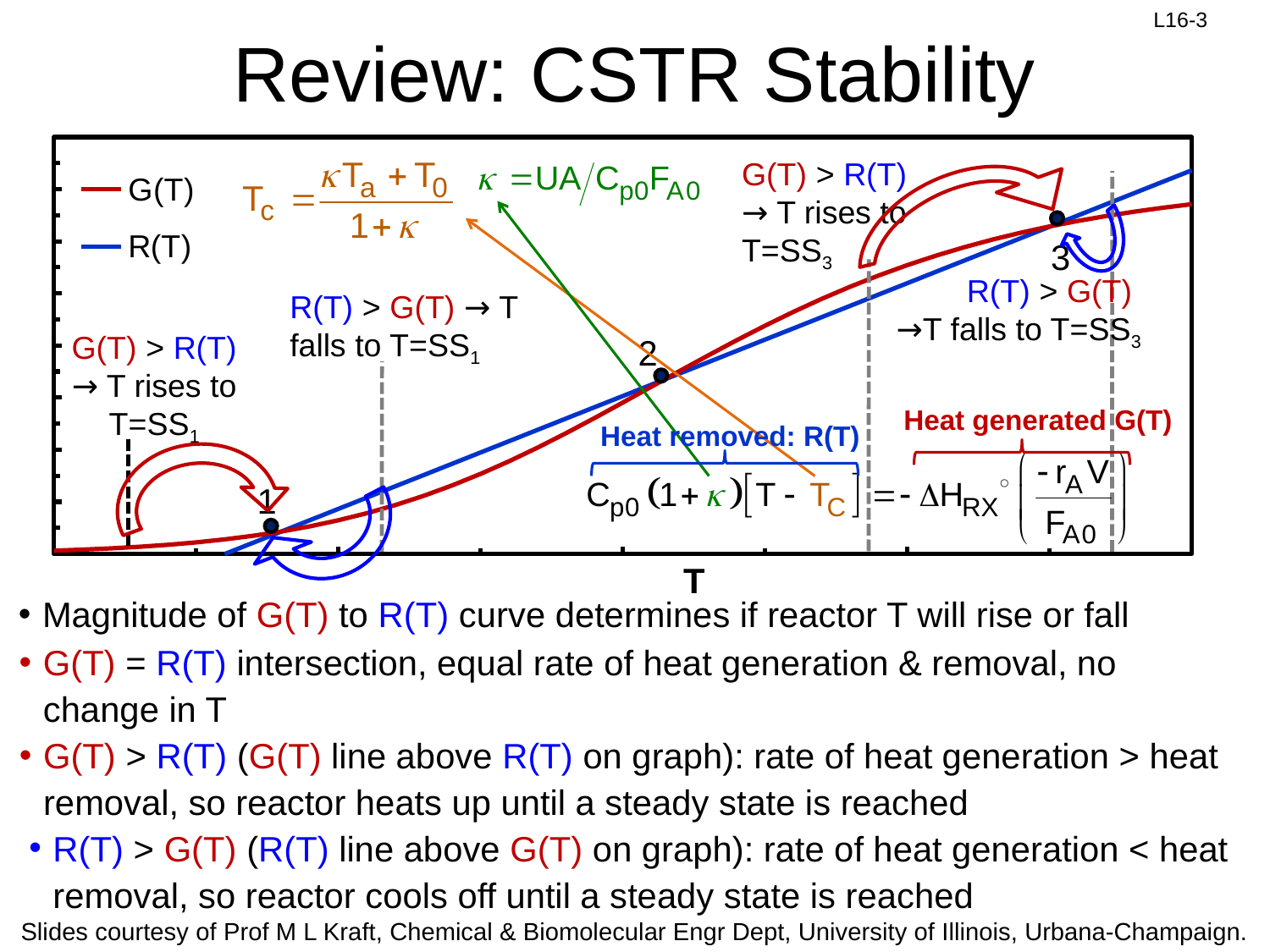
What are the two series named in the chart legend? G(T) and R(T) To the right of steady state 3, which curve is higher, G(T) or R(T)? R(T) How many series does the chart legend list? 2 Does the G(T) curve rise or fall as T increases along the x axis? rises Between steady states 1 and 2, which curve is higher, G(T) or R(T)? R(T) What kind of chart is shown on the slide? line chart Between steady states 2 and 3, which curve is higher, G(T) or R(T)? G(T) What is the label on the x axis of the chart? T What colour is the G(T) curve in the chart? red How many intersection (steady-state) points are marked on the chart? 3 Does the R(T) line rise or fall as T increases along the x axis? rises